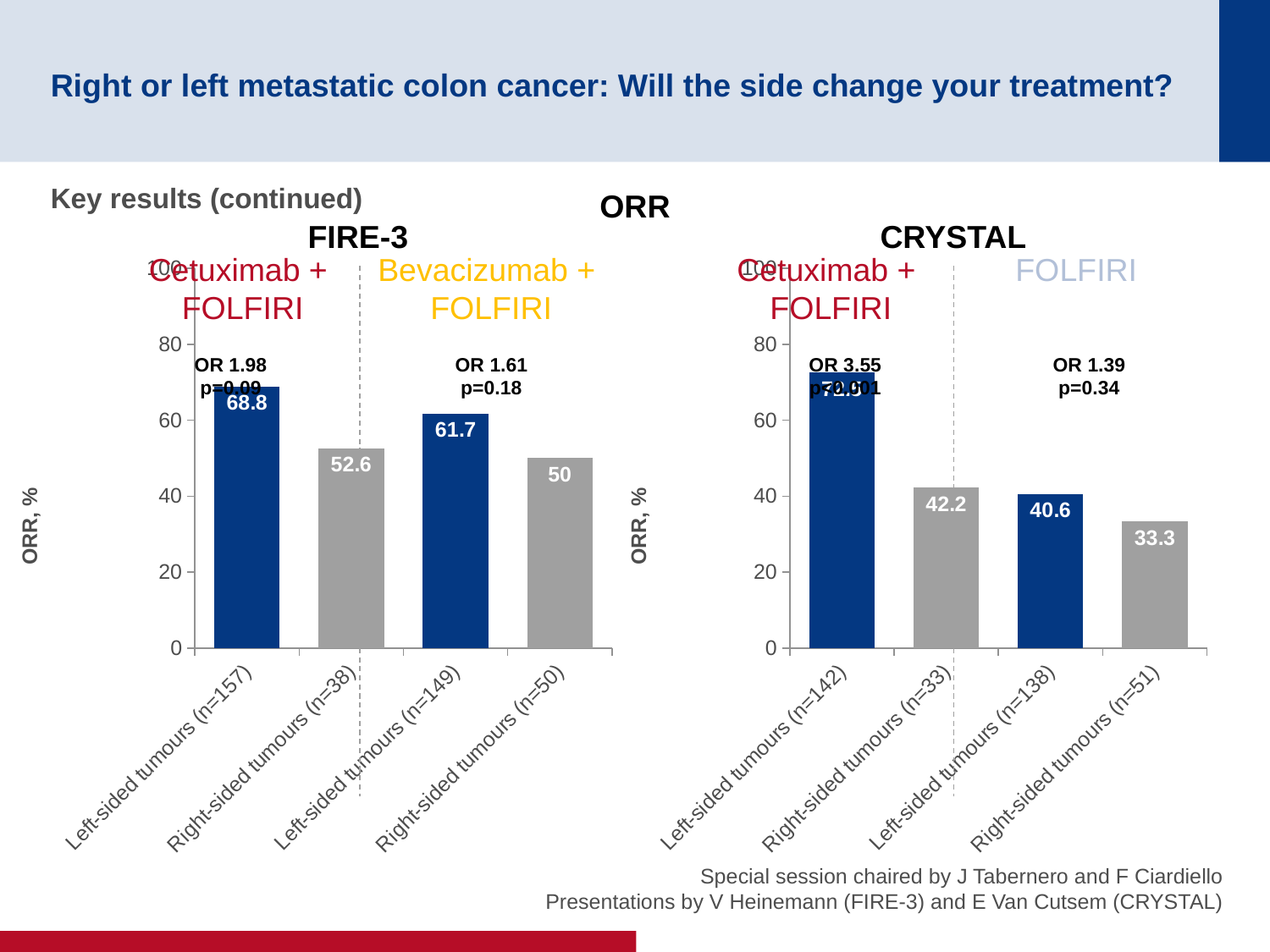
In the FIRE-3 chart, what is the ORR for left-sided tumours (n=157) with cetuximab + FOLFIRI? 68.8 How many bars are plotted in the FIRE-3 chart? 4 What type of chart is used for the CRYSTAL results? Bar chart In the FIRE-3 chart, what is the ORR for right-sided tumours (n=38) with cetuximab + FOLFIRI? 52.6 In the CRYSTAL chart, what is the ORR for right-sided tumours (n=51) with FOLFIRI? 33.3 In the FIRE-3 chart, which bar has the highest ORR? Left-sided tumours (n=157), cetuximab + FOLFIRI In the FIRE-3 chart, what is the ORR for right-sided tumours (n=50) with bevacizumab + FOLFIRI? 50 In the CRYSTAL chart, which bar has the lowest ORR? Right-sided tumours (n=51), FOLFIRI In the CRYSTAL chart, what is the difference in ORR between left-sided (n=138) and right-sided (n=51) tumours with FOLFIRI? 7.3 In the CRYSTAL chart, is the ORR for left-sided tumours (n=142) with cetuximab + FOLFIRI greater or less than 60? greater In the FIRE-3 chart, what is the difference in ORR between left-sided (n=157) and right-sided (n=38) tumours with cetuximab + FOLFIRI? 16.2 In the CRYSTAL chart, what is the ORR for left-sided tumours (n=138) with FOLFIRI? 40.6